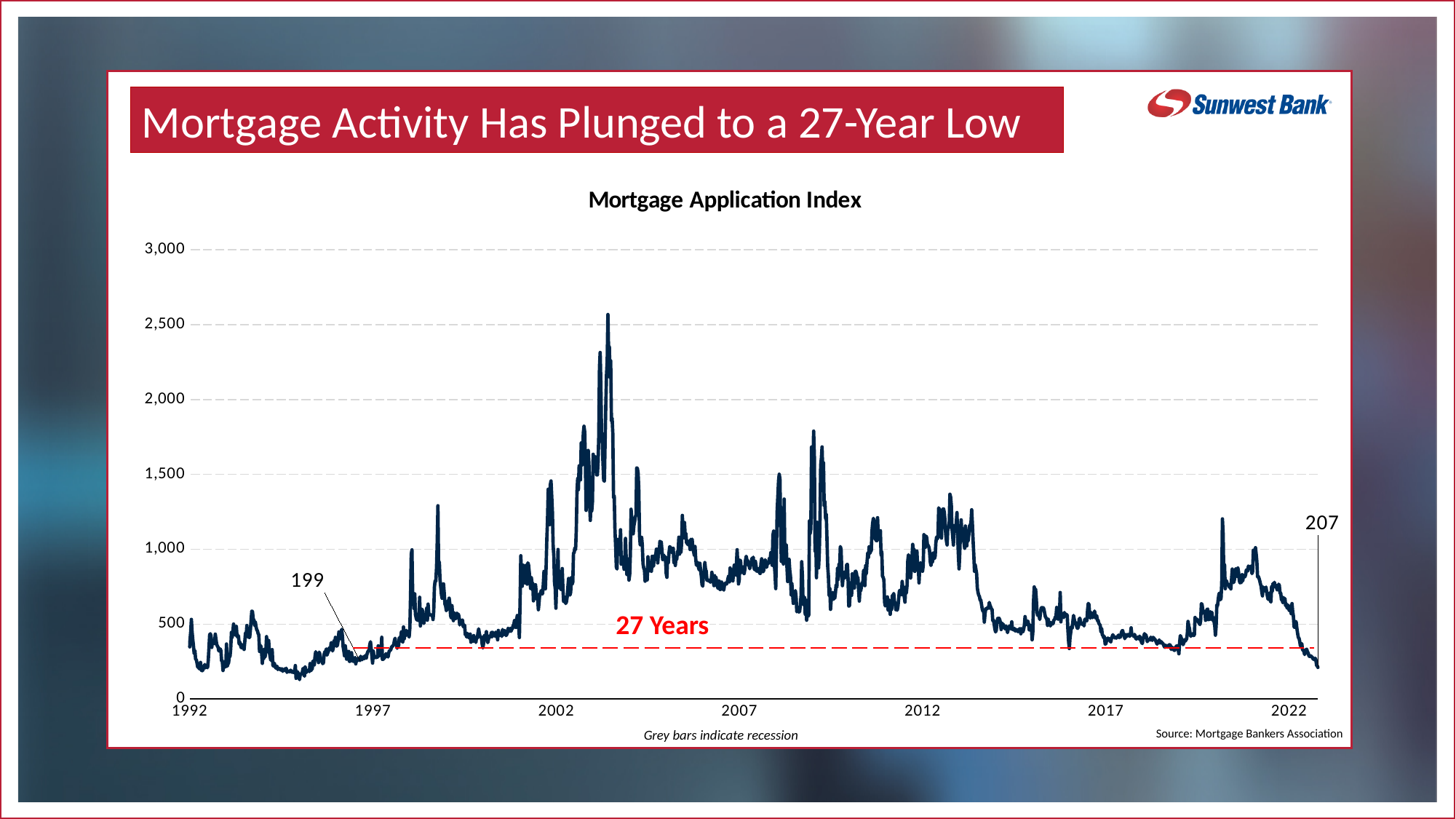
Between which two labeled years on the x axis does the highest peak of the index occur? 2002 and 2007 Is the highest peak of the index, between 2002 and 2007, greater or less than 2,000? greater Is the value of the index at 2017 greater or less than 1,000? less What is the data label shown at the end of the series, near 2022? 207 What text labels the red dashed horizontal line on the chart? 27 Years Which labeled value is larger, the one near 1997 or the one at the end of the series? the one at the end of the series (207) What is the data label shown on the series near 1997? 199 What kind of chart is shown on the slide? line chart From the peak around 2021 to the end of the series, does the index rise or fall? fall What is the title of the chart? Mortgage Application Index What is the difference between the two labeled values, 207 and 199? 8 How many year labels are shown on the x axis? 7